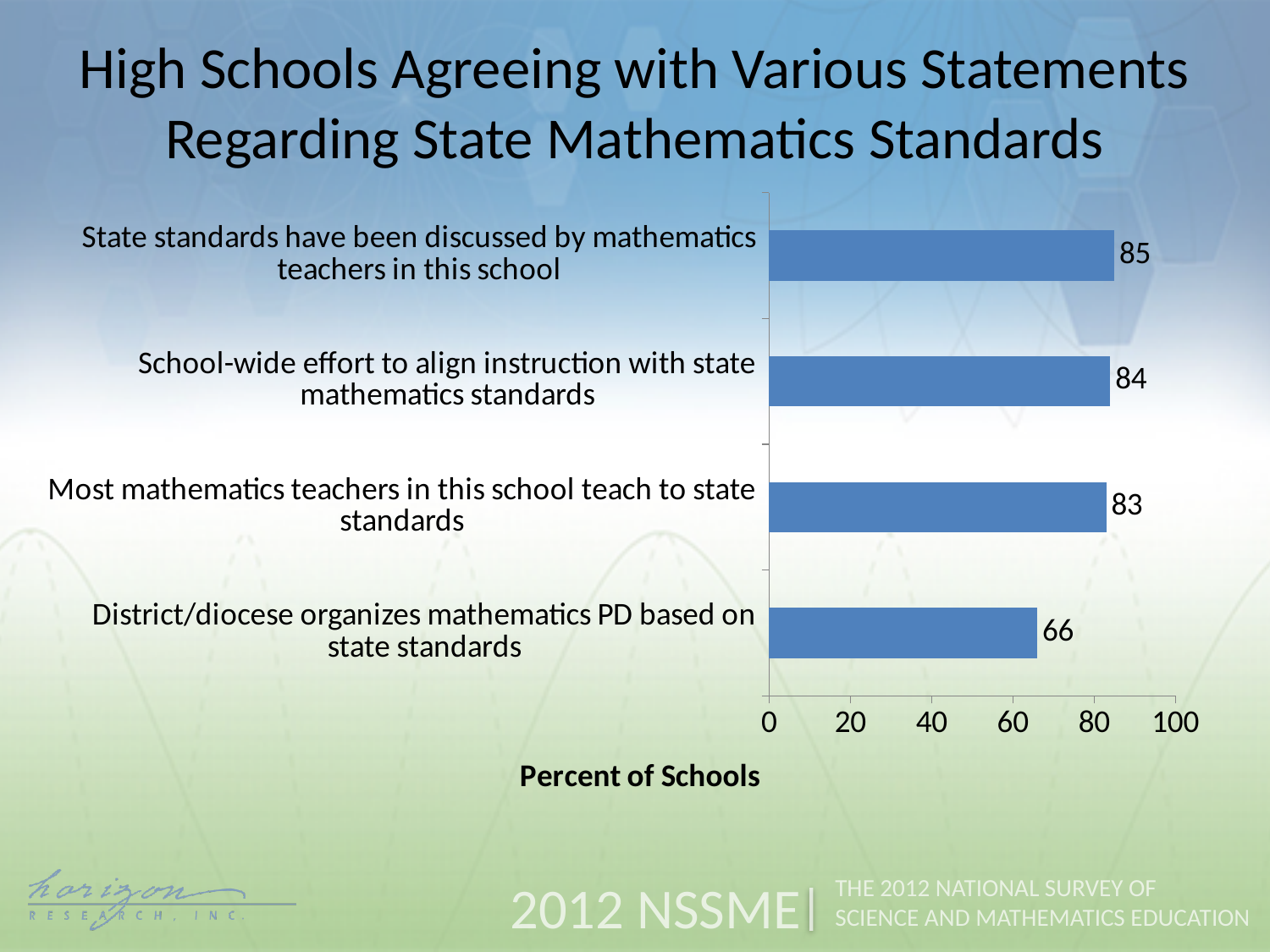
Is the value for 'District/diocese organizes mathematics PD based on state standards' greater or less than 80? less Which statement has the highest percent of schools agreeing? State standards have been discussed by mathematics teachers in this school How many statements are shown in the chart? 4 What percent of high schools agree that the district/diocese organizes mathematics PD based on state standards? 66 What is the value for 'School-wide effort to align instruction with state mathematics standards'? 84 What percent of high schools agree that state standards have been discussed by mathematics teachers in this school? 85 What is the label of the horizontal axis? Percent of Schools What kind of chart is shown on the slide? bar chart What is the value for 'Most mathematics teachers in this school teach to state standards'? 83 Which is larger: the value for 'School-wide effort to align instruction with state mathematics standards' or the value for 'District/diocese organizes mathematics PD based on state standards'? School-wide effort to align instruction with state mathematics standards Which statement has the lowest percent of schools agreeing? District/diocese organizes mathematics PD based on state standards What is the difference between the value for 'State standards have been discussed by mathematics teachers in this school' and the value for 'District/diocese organizes mathematics PD based on state standards'? 19